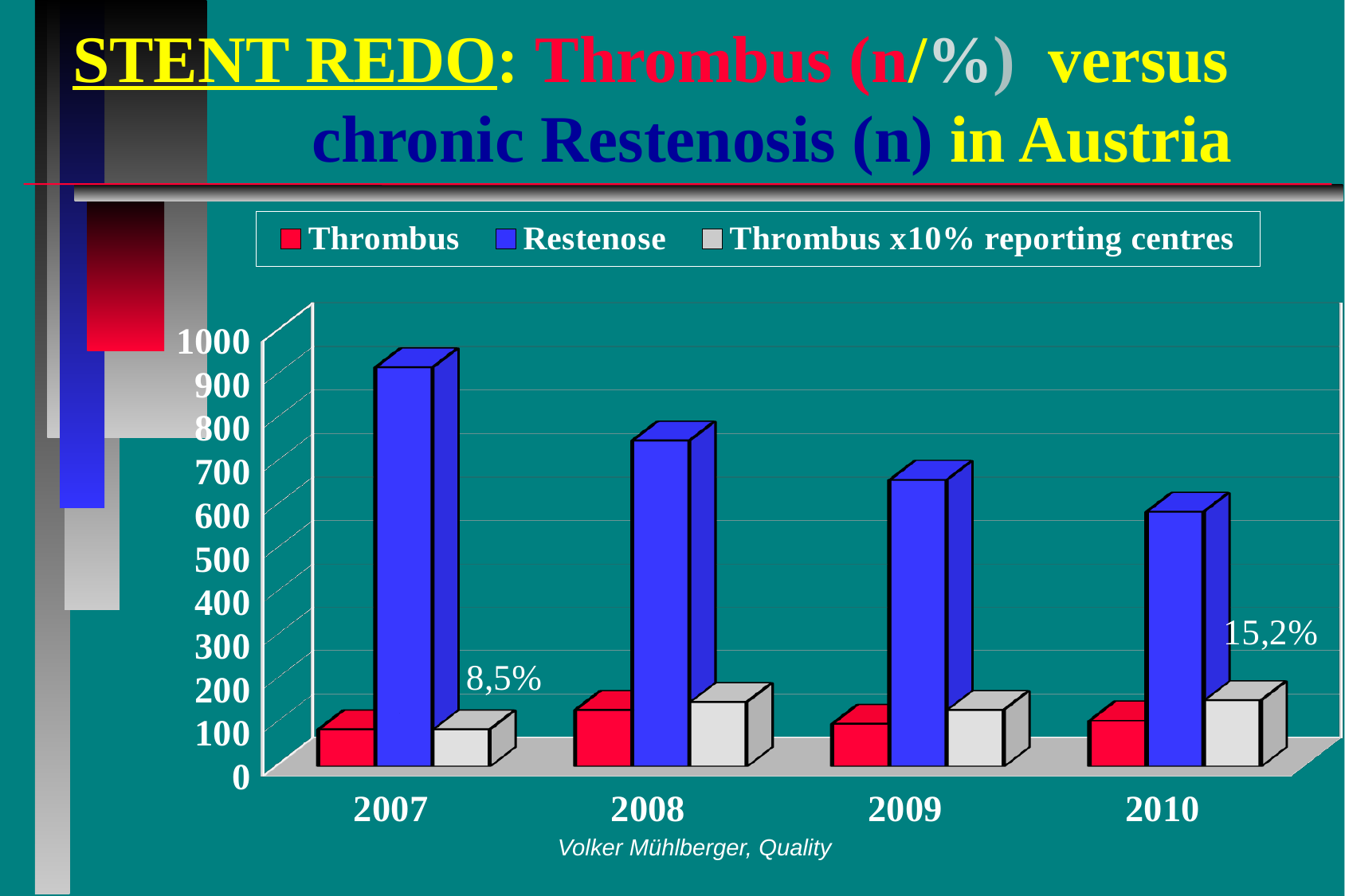
What percentage label is printed next to the 2010 bars? 15,2% Is the Restenose value for 2010 greater or less than 700? less What kind of chart is shown on the slide? bar chart Do the Restenose values rise or fall from 2007 to 2010? fall In which year is the Restenose value highest? 2007 How many series does the legend list? 3 Which is larger, the Thrombus value for 2007 or for 2008? 2008 In which year is the Restenose value lowest? 2010 Is the Restenose value for 2008 greater or less than 700? greater How many years are shown on the x axis? 4 Which is larger, the Restenose value for 2008 or for 2009? 2008 Is the Restenose value for 2007 greater or less than 800? greater